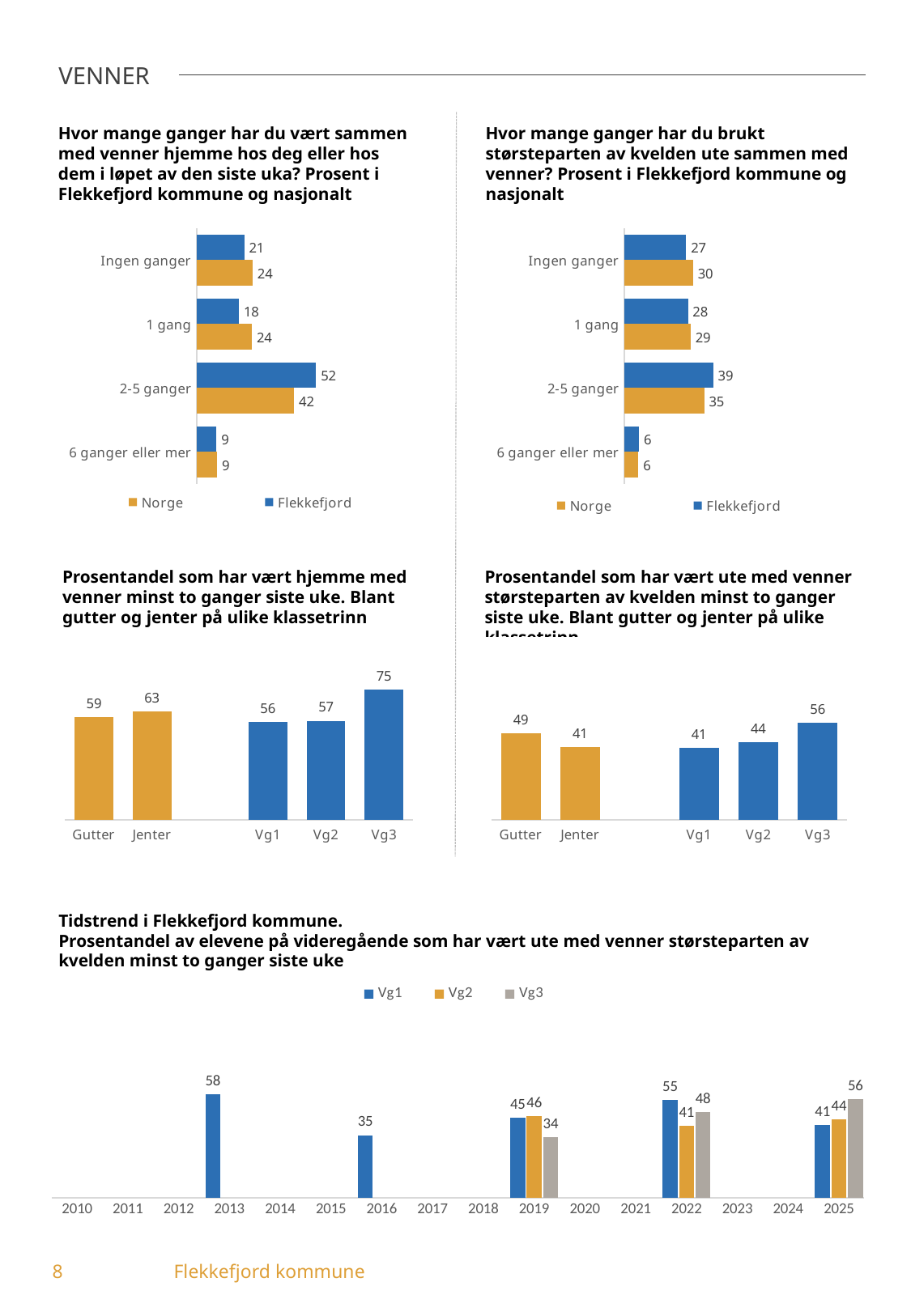
In the top-left chart (friends at home in the last week), what is the Flekkefjord value for '2-5 ganger'? 52 In the middle-right chart (out with friends at least twice, by gender and grade), which is larger, Gutter or Jenter? Gutter In the bottom chart (Tidstrend i Flekkefjord kommune), what is the Vg3 value for 2025? 56 In the top-right chart (evenings out with friends), how many series does the legend list? 2 In the top-left chart (friends at home in the last week), what is the Norge value for '1 gang'? 24 In the middle-left chart (at home with friends at least twice, by gender and grade), what is the value for Jenter? 63 In the top-right chart (evenings out with friends), what is the Norge value for 'Ingen ganger'? 30 In the middle-left chart (at home with friends at least twice, by gender and grade), which category has the highest value? Vg3 In the top-right chart (evenings out with friends), which category has the lowest values for both Norge and Flekkefjord? 6 ganger eller mer In the middle-right chart (out with friends at least twice, by gender and grade), what is the difference between Vg3 and Vg1? 15 In the bottom chart (Tidstrend i Flekkefjord kommune), what is the Vg1 value for 2013? 58 In the top-left chart (friends at home in the last week), what is the difference between the Flekkefjord and Norge values for '2-5 ganger'? 10